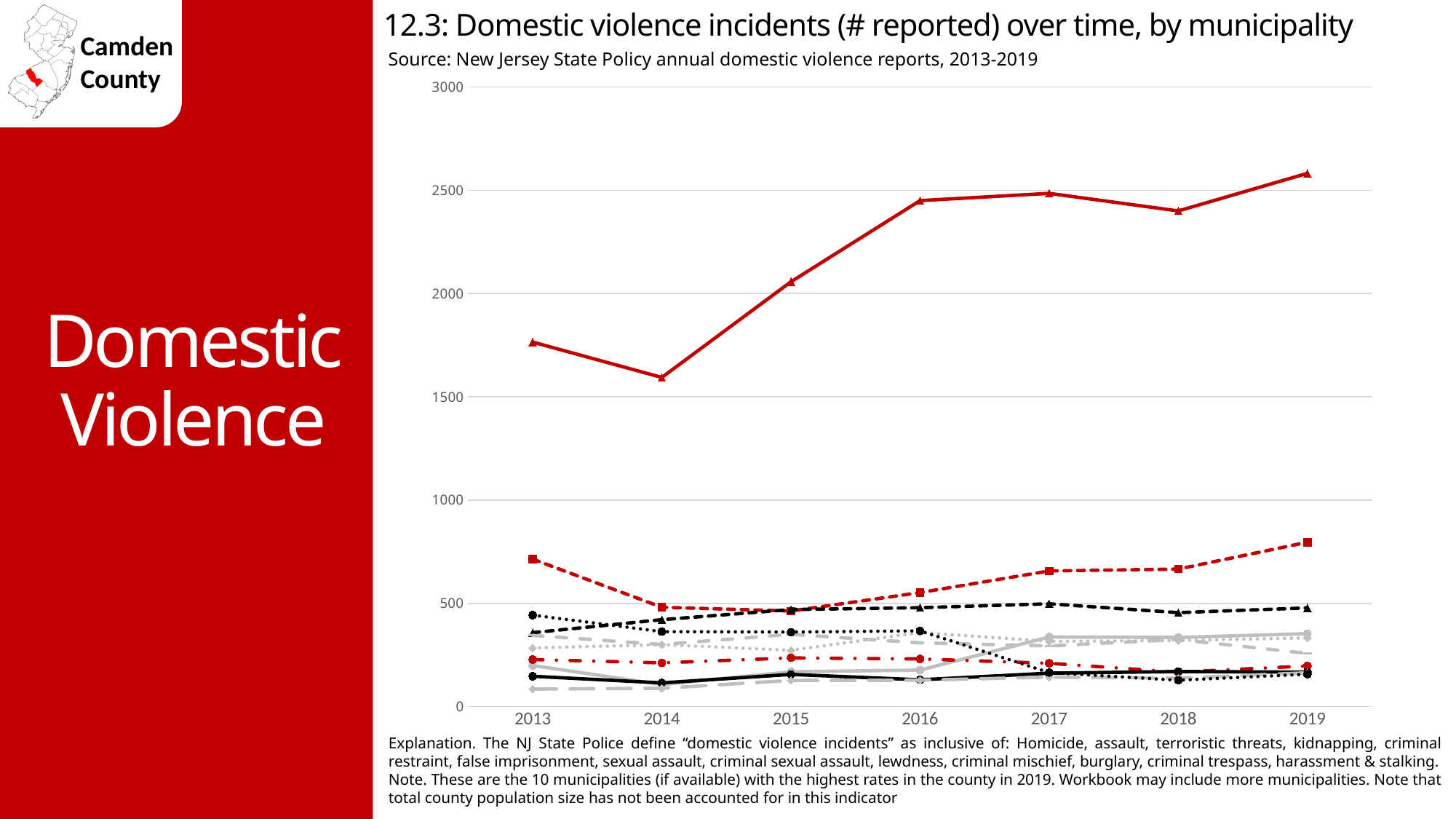
Is the value of the highest line (solid red with triangle markers) in 2019 greater or less than 2500? greater What source is cited for the chart data? New Jersey State Policy annual domestic violence reports, 2013-2019 Is the value of the dashed red line with square markers in 2019 greater or less than 500? greater In which year does the highest line (solid red with triangle markers) reach its lowest value? 2014 What kind of chart is shown on the slide? line chart What is the title of the chart on the slide? 12.3: Domestic violence incidents (# reported) over time, by municipality Is the value of the dashed red line with square markers in 2019 greater or less than 1000? less In which year does the highest line (solid red with triangle markers) reach its highest value? 2019 How many years are shown along the x axis of the chart? 7 Does the highest line (solid red with triangle markers) rise or fall between 2014 and 2017? rise